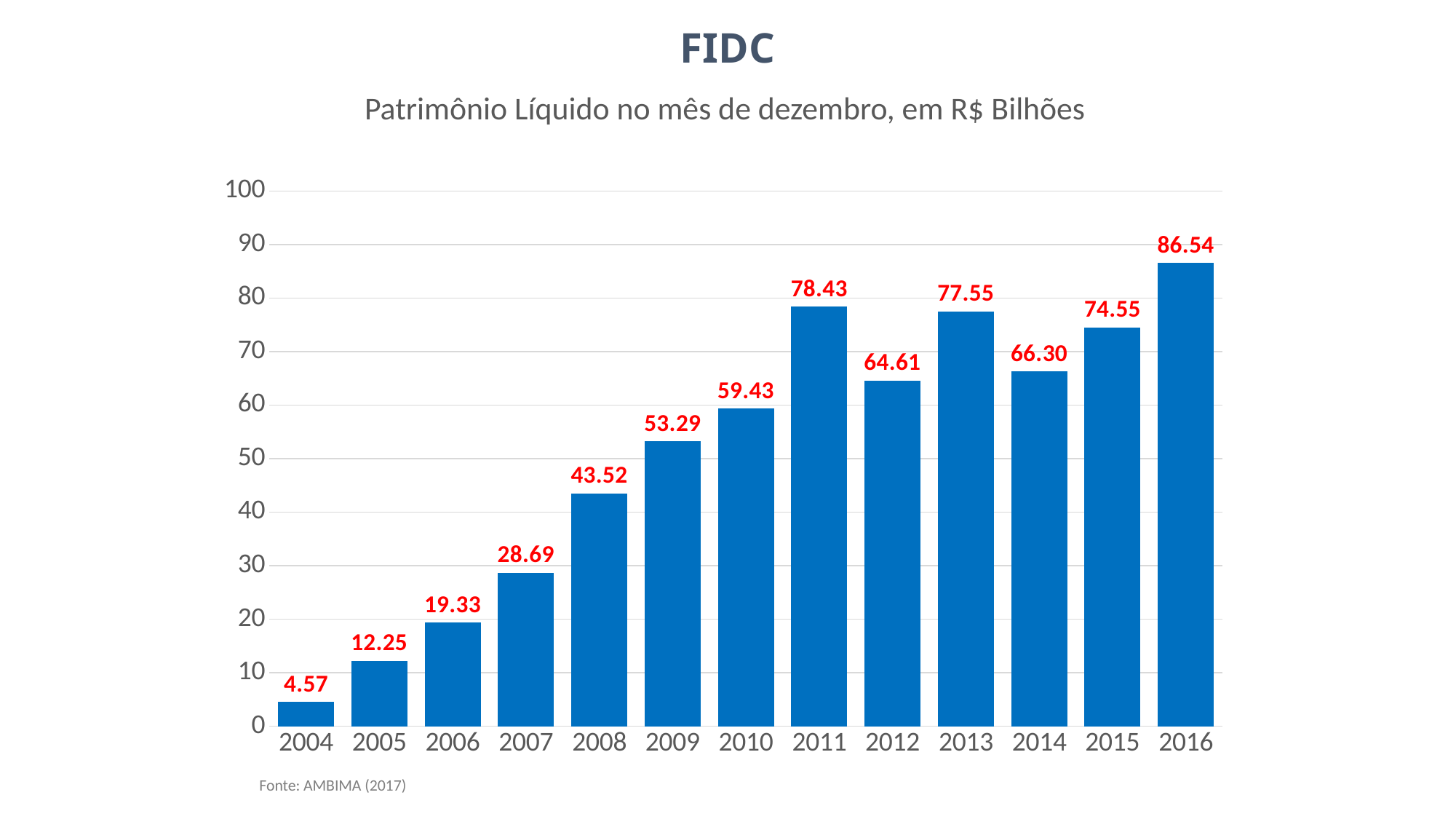
Which year has the lowest value? 2004 What is the difference between the values for 2011 and 2012? 13.82 Which is larger, the value for 2013 or the value for 2014? 2013 What is the value for 2014? 66.30 What is the difference between the values for 2016 and 2015? 11.99 How many years are shown on the x axis? 13 What is the title of the chart? FIDC Is the value for 2009 greater or less than 50? greater What kind of chart is this? bar chart What is the value for 2004? 4.57 What is the value for 2011? 78.43 Which year has the highest value? 2016